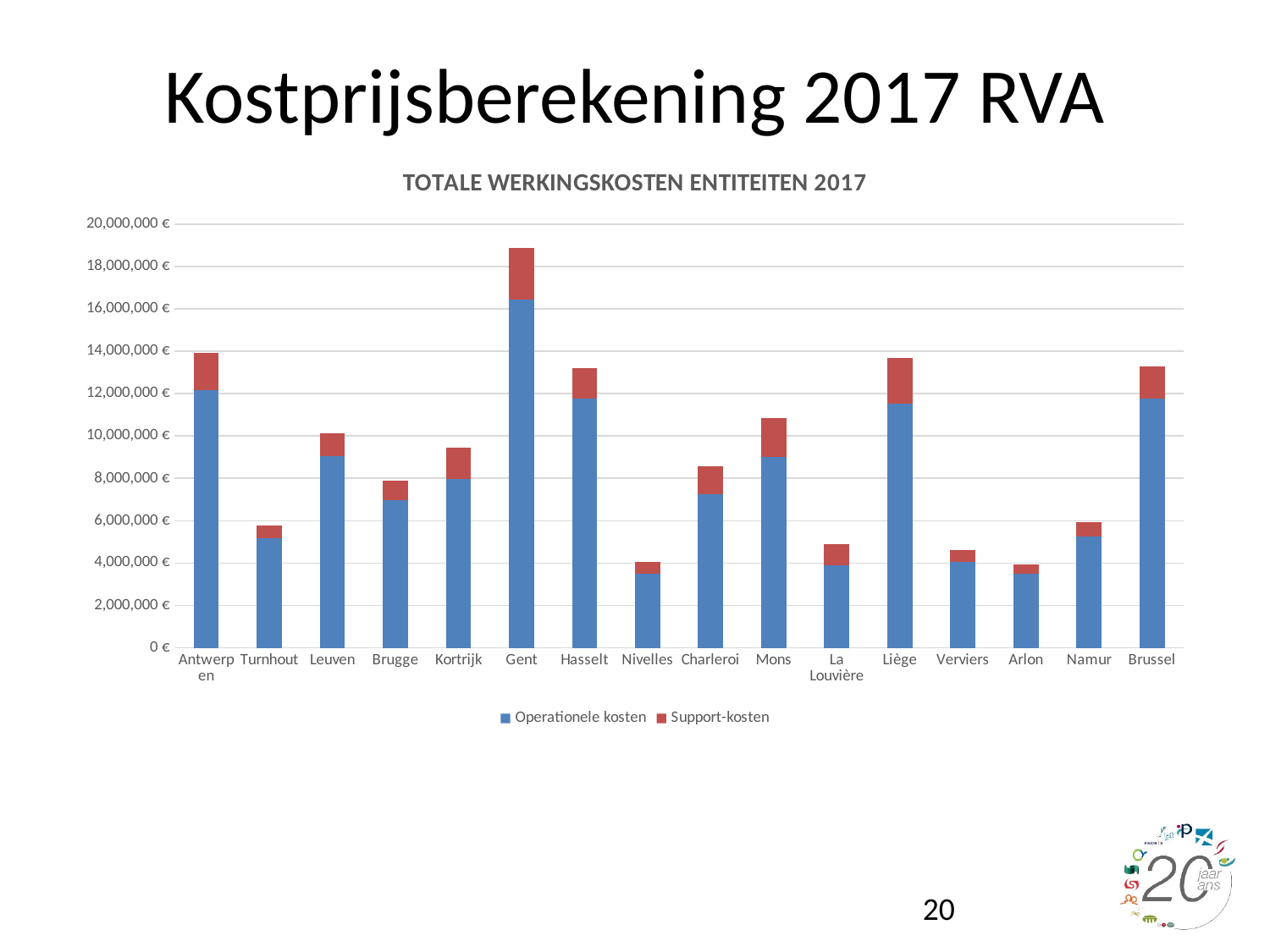
Is the total value for Kortrijk greater or less than 10,000,000 €? less Which entity has the highest total bar in the chart? Gent What kind of chart is shown on the slide? Stacked bar chart Which has the larger total bar, Gent or Antwerpen? Gent Is the total value for Turnhout greater or less than 6,000,000 €? less Which has the larger total bar, Liège or Mons? Liège Is the total value for Gent greater or less than 18,000,000 €? greater How many entities (categories) are shown on the x axis of the chart? 16 What is the title of the chart? TOTALE WERKINGSKOSTEN ENTITEITEN 2017 How many series does the legend list? 2